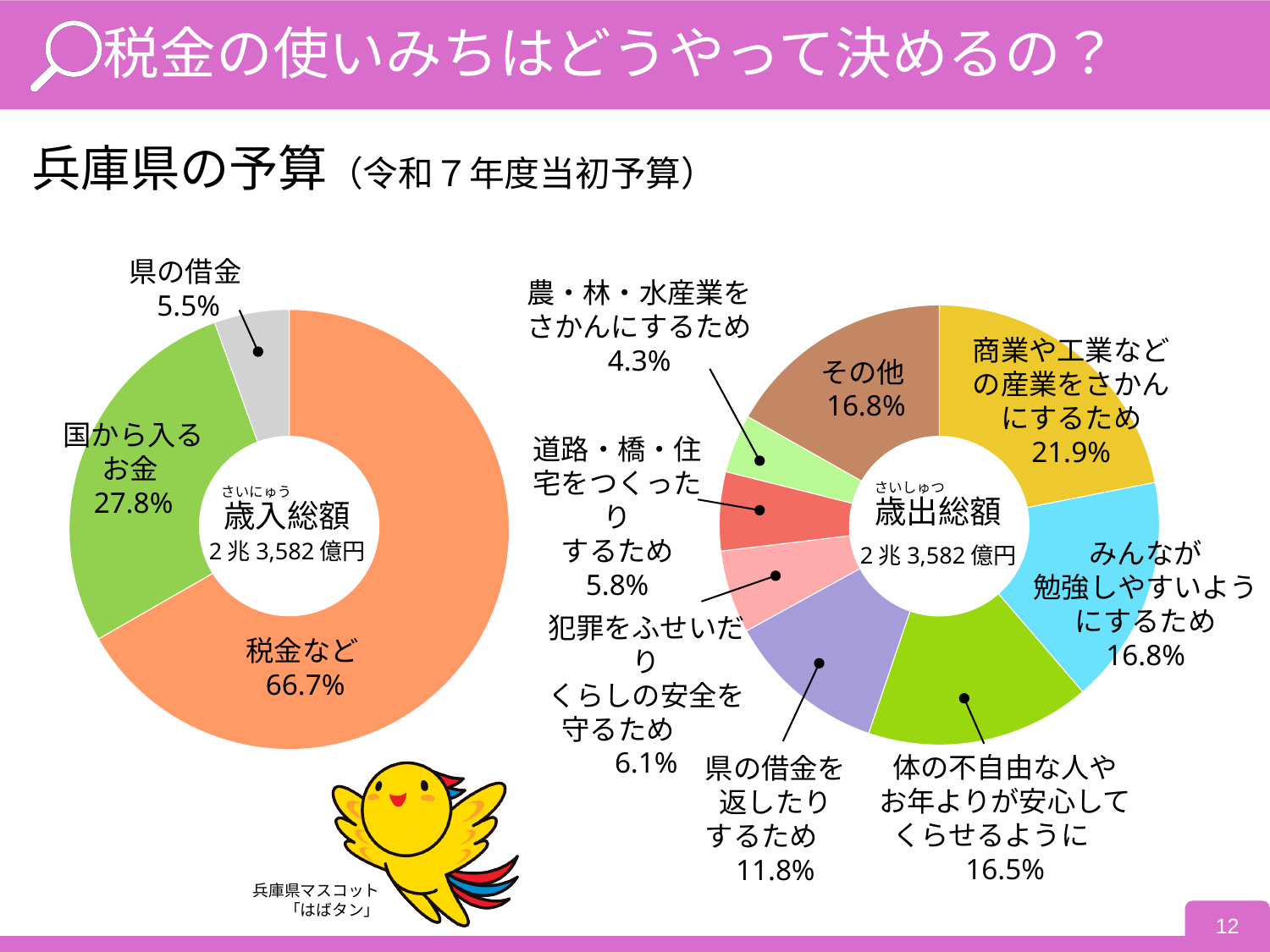
In the 歳入総額 chart, how many categories are shown? 3 What kind of chart is the 歳出総額 chart? Donut (pie) chart In the 歳入総額 chart, which category has the smallest share? 県の借金 In the 歳出総額 chart, which category has the smallest share? 農・林・水産業をさかんにするため In the 歳出総額 chart, which category has the largest share? 商業や工業などの産業をさかんにするため In the 歳出総額 chart, which is larger: 犯罪をふせいだりくらしの安全を守るため or 道路・橋・住宅をつくったりするため? 犯罪をふせいだりくらしの安全を守るため In the 歳入総額 chart, what is the difference between the shares of 税金など and 国から入るお金? 38.9% In the 歳出総額 chart, how many categories are shown? 8 What total amount is shown in the centre of the 歳出総額 chart? 2兆3,582億円 In the 歳入総額 chart, what share is 税金など? 66.7% In the 歳入総額 chart, what share is 国から入るお金? 27.8% In the 歳出総額 chart, what share is 県の借金を返したりするため? 11.8%